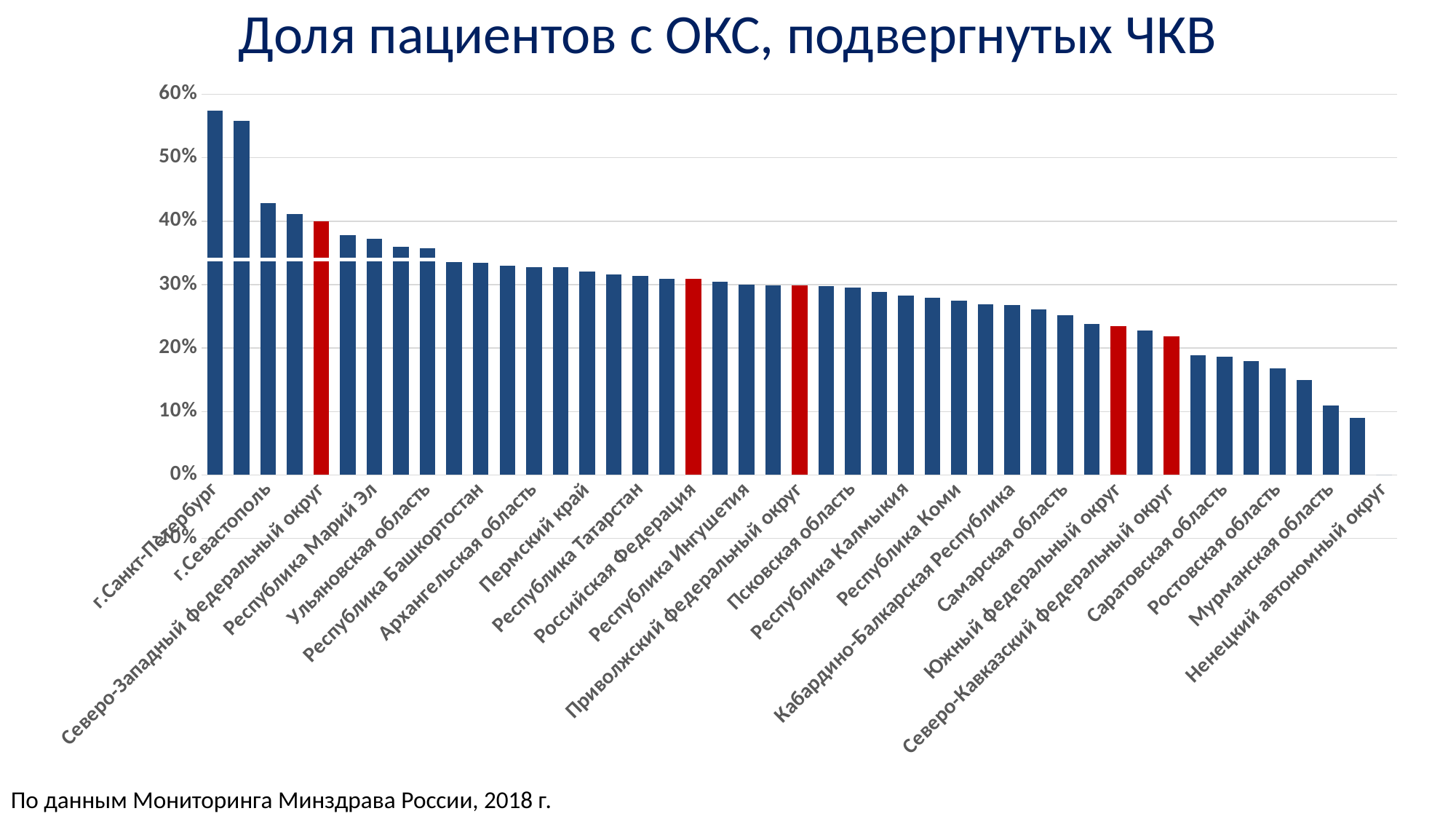
Is the value for Российская Федерация greater or less than 20%? greater Is the value for Северо-Западный федеральный округ greater or less than 30%? greater Which region has the lowest share of ACS patients undergoing PCI? Ненецкий автономный округ Which region has the highest share of ACS patients undergoing PCI? г.Санкт-Петербург Which is larger, the value for Республика Марий Эл or the value for Республика Коми? Республика Марий Эл Is the value for г.Санкт-Петербург greater or less than 50%? greater What is the title of the chart? Доля пациентов с ОКС, подвергнутых ЧКВ Do the values rise or fall from left to right along the x axis? Fall What kind of chart is shown on the slide? Bar chart What colour are the bars for the federal districts and the Russian Federation highlighted in? Red